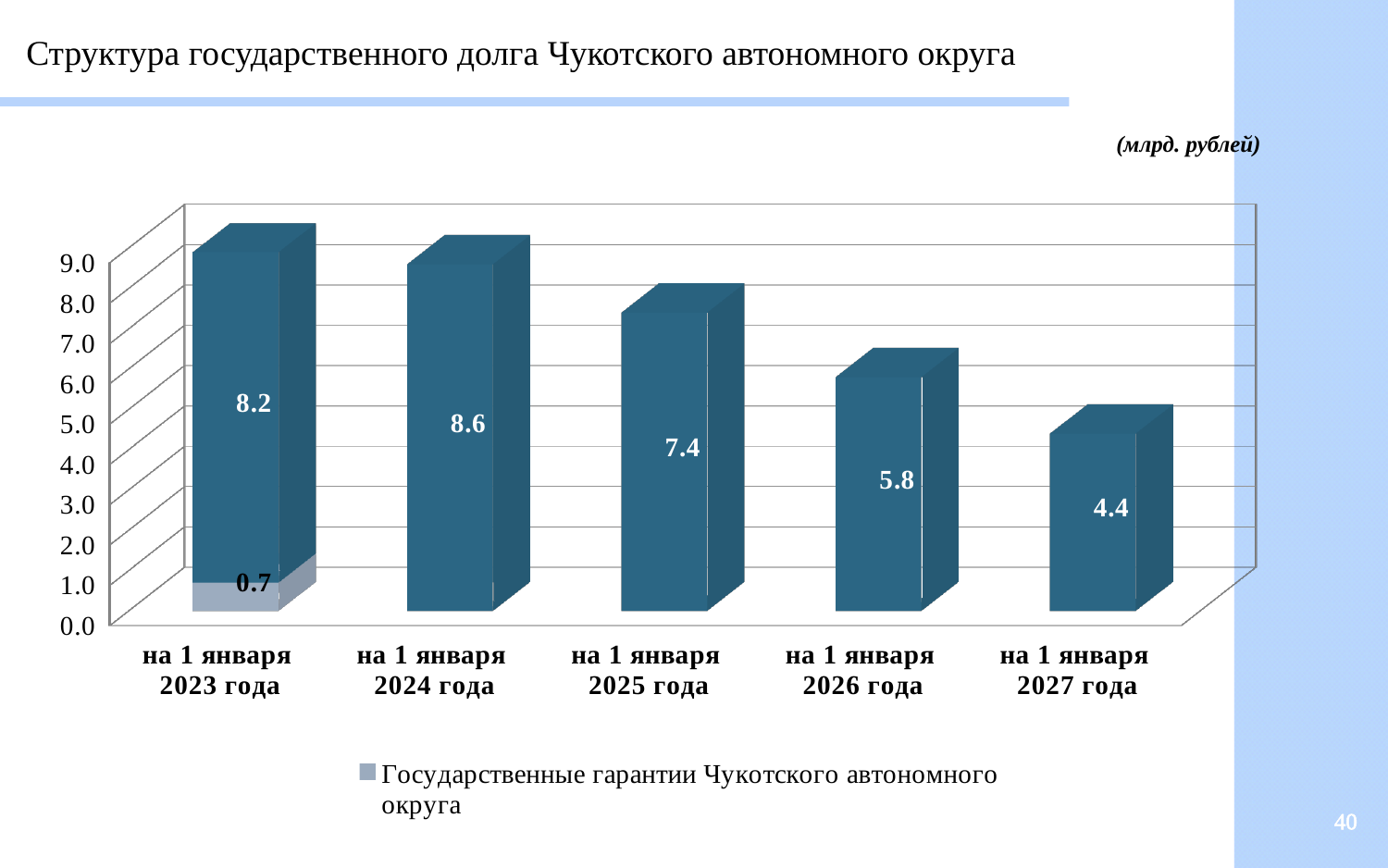
What is the difference between the dark-blue values for "на 1 января 2024 года" and "на 1 января 2027 года"? 4.2 Which is larger: the dark-blue value for "на 1 января 2025 года" or for "на 1 января 2026 года"? на 1 января 2025 года What is the total height of the stacked bar for "на 1 января 2023 года"? 8.9 From "на 1 января 2024 года" to "на 1 января 2027 года", do the dark-blue values rise or fall? fall What is the value of the dark-blue segment for "на 1 января 2027 года"? 4.4 Which date has the lowest dark-blue segment value? на 1 января 2027 года What is the value of the large dark-blue segment for "на 1 января 2024 года"? 8.6 What is the value of the grey segment (Государственные гарантии) for "на 1 января 2023 года"? 0.7 How many dates are shown on the x axis? 5 What unit is indicated for the chart values? млрд. рублей Which date has the highest dark-blue segment value? на 1 января 2024 года What kind of chart is shown on the slide? bar chart